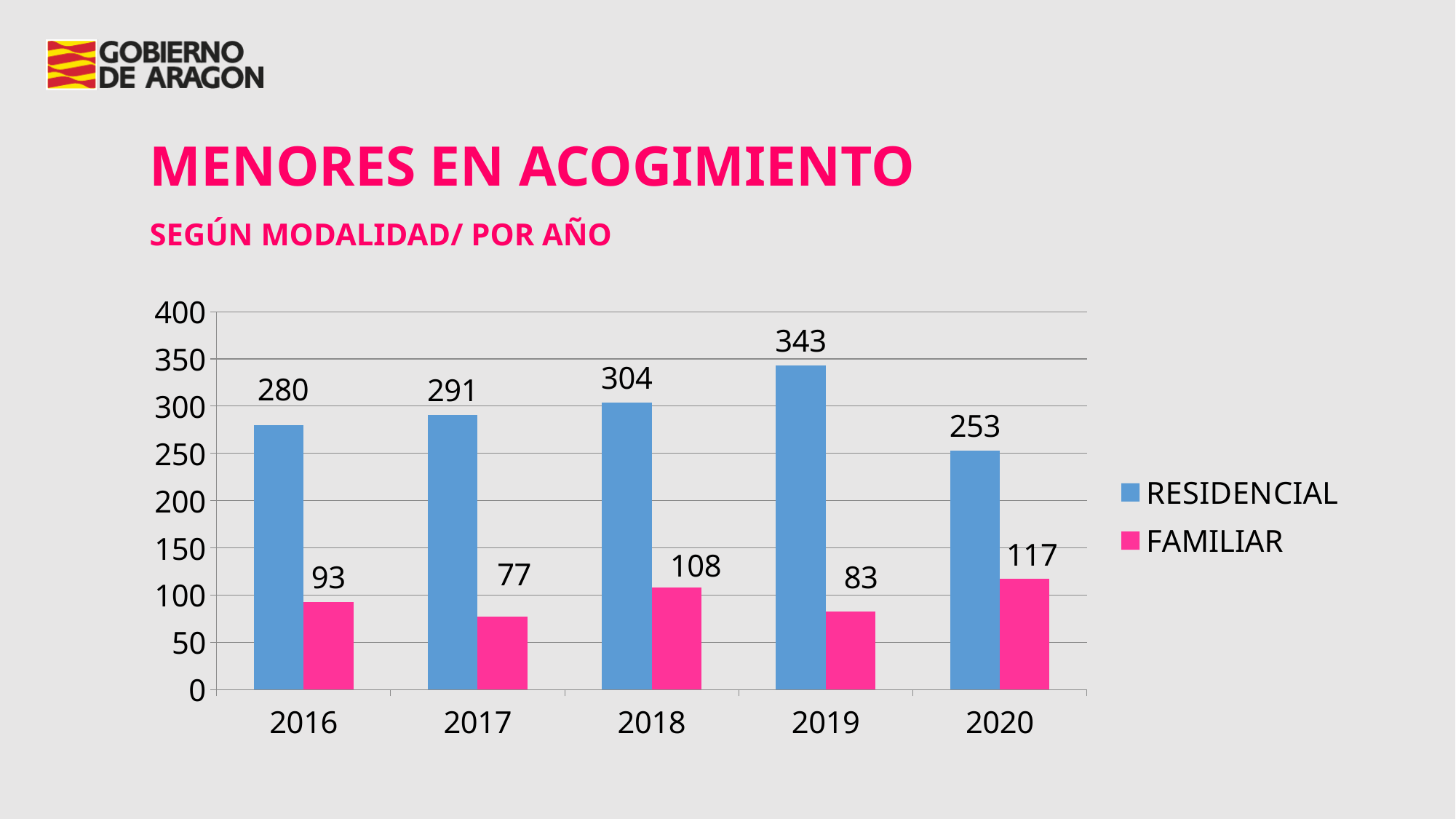
Which year has the lowest FAMILIAR value? 2017 What is the RESIDENCIAL value for 2020? 253 Which colour represents the FAMILIAR series? pink Which year has the highest RESIDENCIAL value? 2019 Which is larger, the FAMILIAR value for 2020 or the FAMILIAR value for 2016? FAMILIAR value for 2020 Is the RESIDENCIAL value for 2017 greater or less than 250? greater How many series does the legend list? 2 How many years are shown on the x axis? 5 What kind of chart is shown on the slide? bar chart What is the FAMILIAR value for 2017? 77 What is the difference between the RESIDENCIAL and FAMILIAR values in 2018? 196 What is the RESIDENCIAL value for 2019? 343